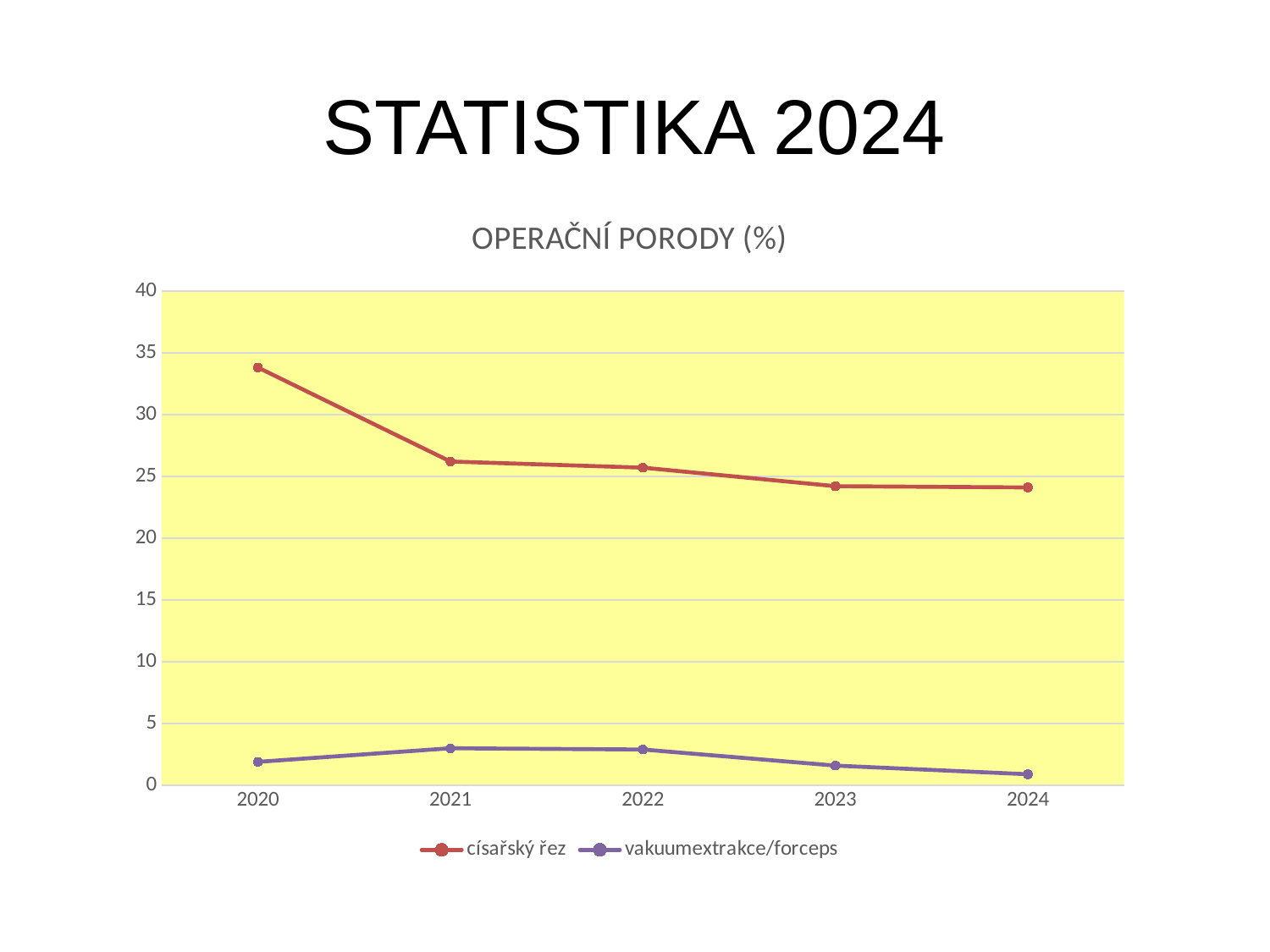
What type of chart is shown on the slide? line chart Is the value for císařský řez in 2024 greater or less than 25? less In which year is the value for vakuumextrakce/forceps lowest? 2024 How many series does the legend list? 2 In which year is the value for císařský řez highest? 2020 How many years are plotted on the x axis? 5 Which series is shown in red? císařský řez Is the value for vakuumextrakce/forceps in 2021 greater or less than 5? less Is the value for císařský řez in 2020 greater or less than 30? greater Does the value for císařský řez rise or fall from 2020 to 2024? fall What is the title of the chart? OPERAČNÍ PORODY (%) Which is larger for císařský řez: the value in 2020 or the value in 2021? 2020